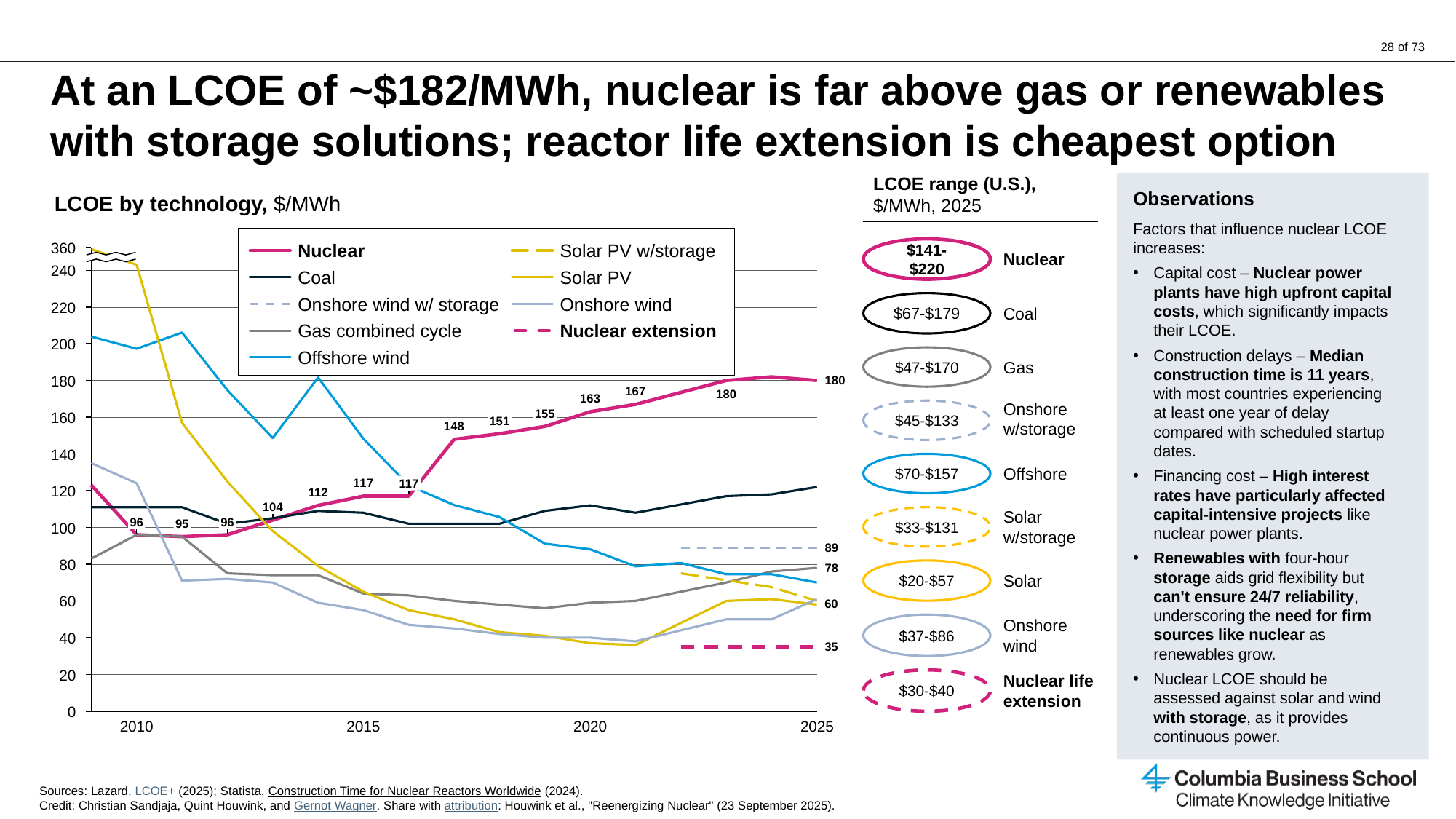
In the 'LCOE by technology' chart, does the Nuclear line rise or fall from 2013 to 2025? rise What kind of chart is the 'LCOE by technology' chart? line chart In the 'LCOE by technology' chart, what is the difference between the Nuclear and Nuclear extension values in 2025? 145 In the 'LCOE by technology' chart, what is the Gas combined cycle value in 2025? 78 In the 'LCOE by technology' chart, is the Offshore wind value in 2010 greater or less than 180? greater How many series does the legend of the 'LCOE by technology' chart list? 9 In the 'LCOE by technology' chart, what is the Nuclear value in 2010? 96 In the 'LCOE range (U.S.)' panel, what is the 2025 LCOE range shown for Nuclear? $141-$220 In the 'LCOE by technology' chart, which series has the highest value in 2025? Nuclear In the 'LCOE by technology' chart, what is the Nuclear extension value in 2025? 35 In the 'LCOE by technology' chart, what is the Nuclear value in 2025? 180 In the 'LCOE by technology' chart, what is the Nuclear value in 2020? 163